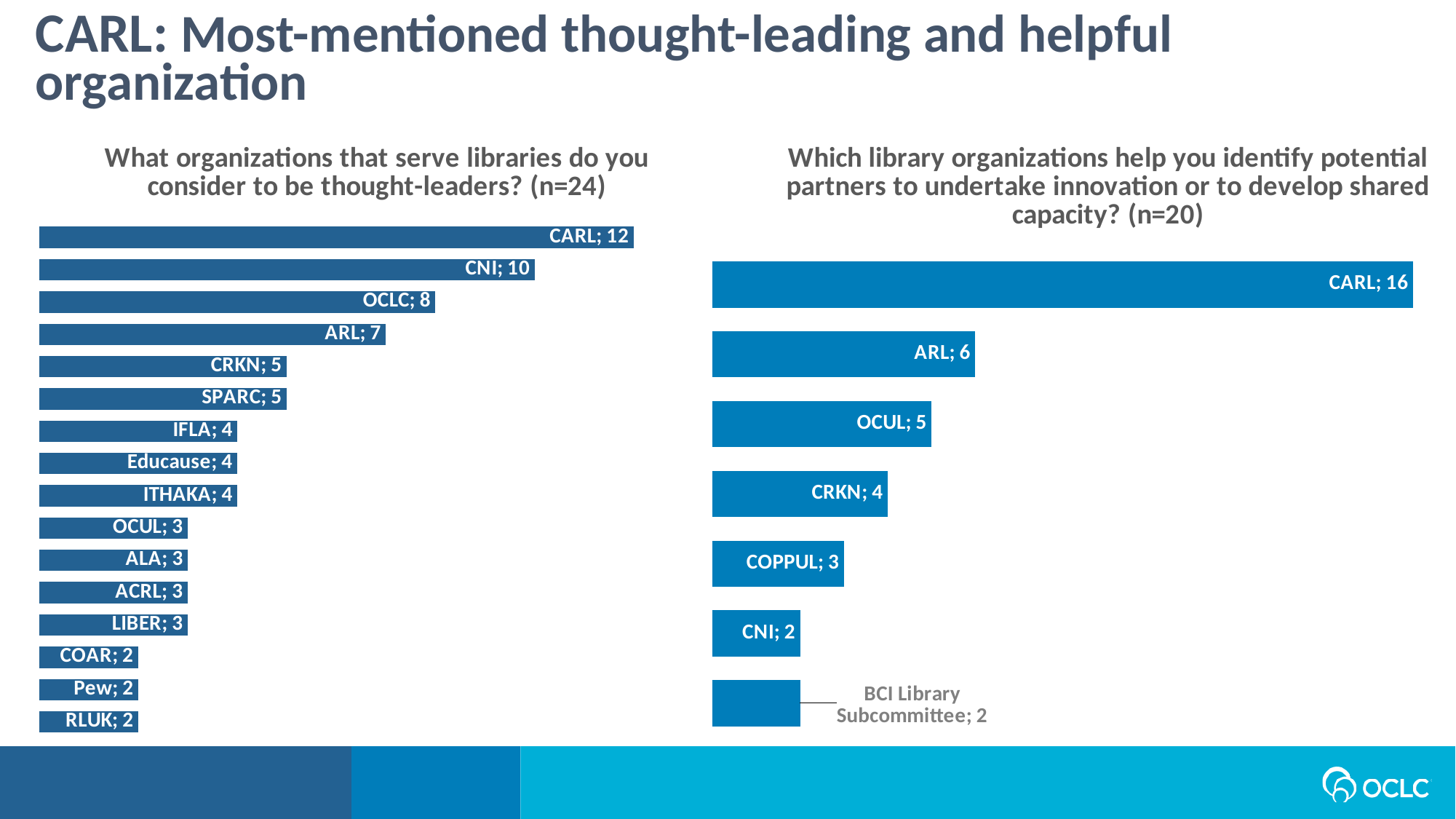
What is the value for BCI Library Subcommittee in the right chart (identify potential partners)? 2 In the right chart (identify potential partners), what is the difference between CARL and ARL? 10 In the right chart (identify potential partners), what is the value for OCUL? 5 How many organizations are shown in the left chart (thought-leaders)? 16 In the left chart (thought-leaders), which organization has the highest value? CARL In the left chart (thought-leaders), what is the difference between OCLC and ARL? 1 How many organizations are shown in the right chart (identify potential partners)? 7 In the right chart (identify potential partners), which is larger, the value for COPPUL or the value for CNI? COPPUL What kind of chart is the right chart (identify potential partners)? Bar chart In the left chart (thought-leaders), which is larger, the value for CRKN or the value for IFLA? CRKN In the right chart (identify potential partners), which organization has the highest value? CARL In the left chart (thought-leaders), what is the value for CNI? 10